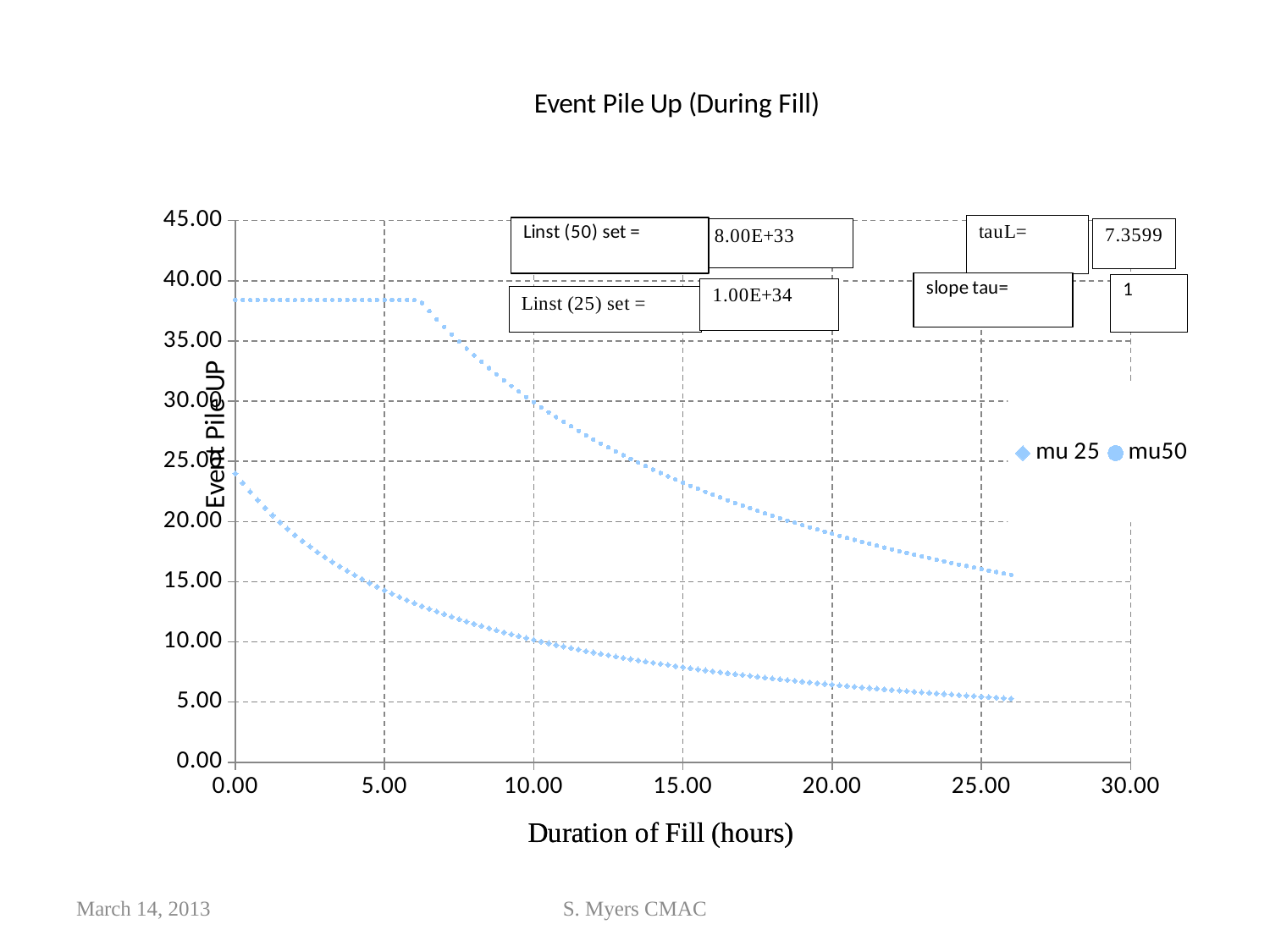
What is the label of the x axis? Duration of Fill (hours) Do the values of the mu 25 series rise or fall as the duration of fill increases? fall How many series does the legend list? 2 Is the value for mu 25 at 15.00 hours greater or less than 10.00? less Which series has the larger value at 10.00 hours, mu 25 or mu50? mu50 What kind of chart is shown on the slide? scatter chart Is the value for mu50 at 15.00 hours greater or less than 20.00? greater Is the value for mu 25 at 0.00 hours greater or less than 20.00? greater Do the values of the mu50 series rise or fall as the duration of fill increases? fall What is the title of the chart? Event Pile Up (During Fill)